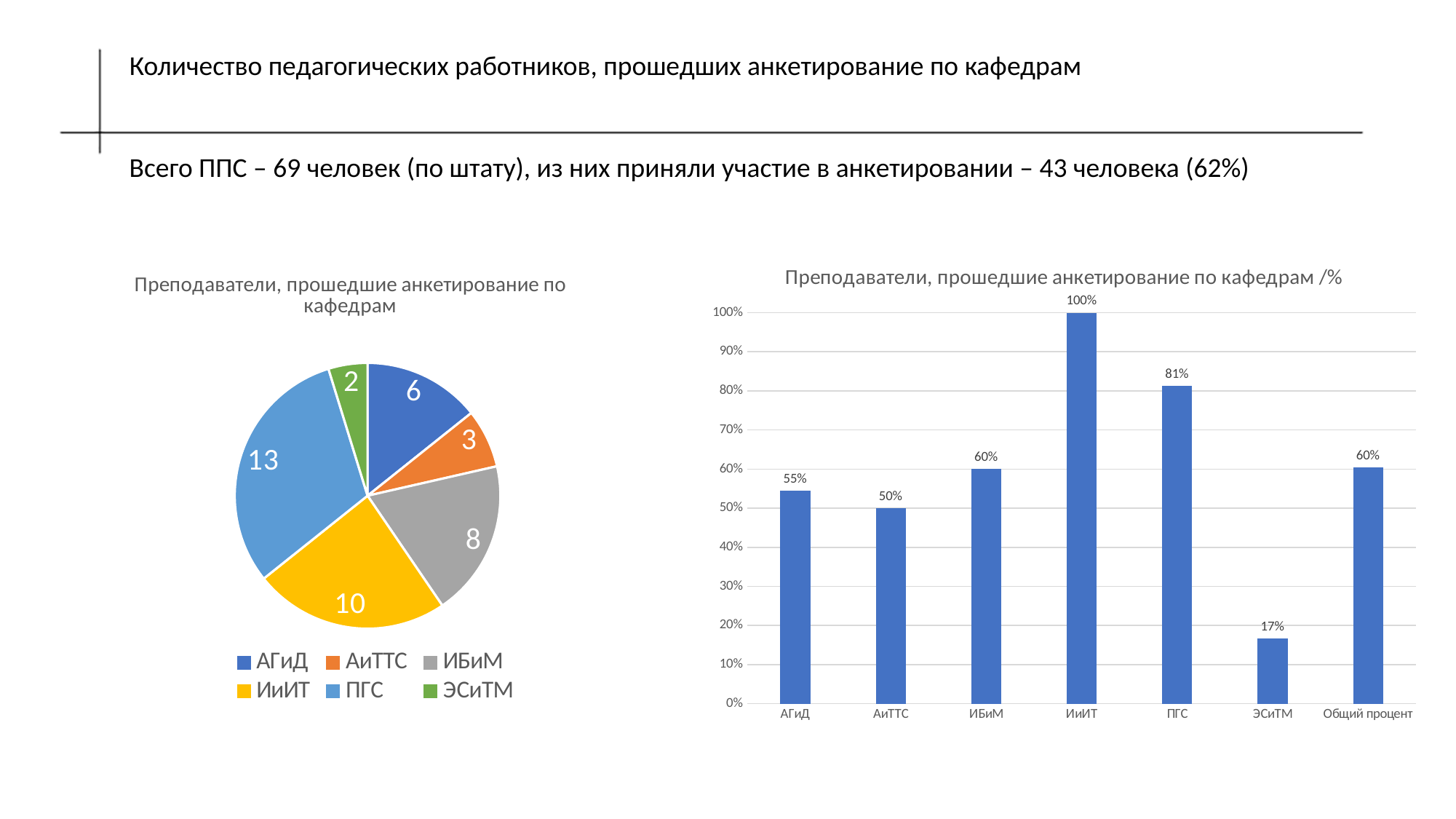
In the pie chart on the left, what is the value for ИиИТ? 10 In the bar chart on the right, what is the value for ПГС? 81% In the pie chart on the left, what is the difference between the values for ИБиМ and АиТТС? 5 In the pie chart on the left, which department has the largest slice? ПГС In the bar chart on the right, which category has the highest value? ИиИТ In the bar chart on the right, what is the difference between the values for ИиИТ and ПГС? 19% In the bar chart on the right, what is the value for ЭСиТМ? 17% In the pie chart on the left, what is the value for ПГС? 13 In the pie chart on the left, which department has the smallest slice? ЭСиТМ How many slices does the pie chart on the left have? 6 What kind of chart is the chart on the right? Bar chart In the bar chart on the right, which is larger, the value for АГиД or the value for АиТТС? АГиД